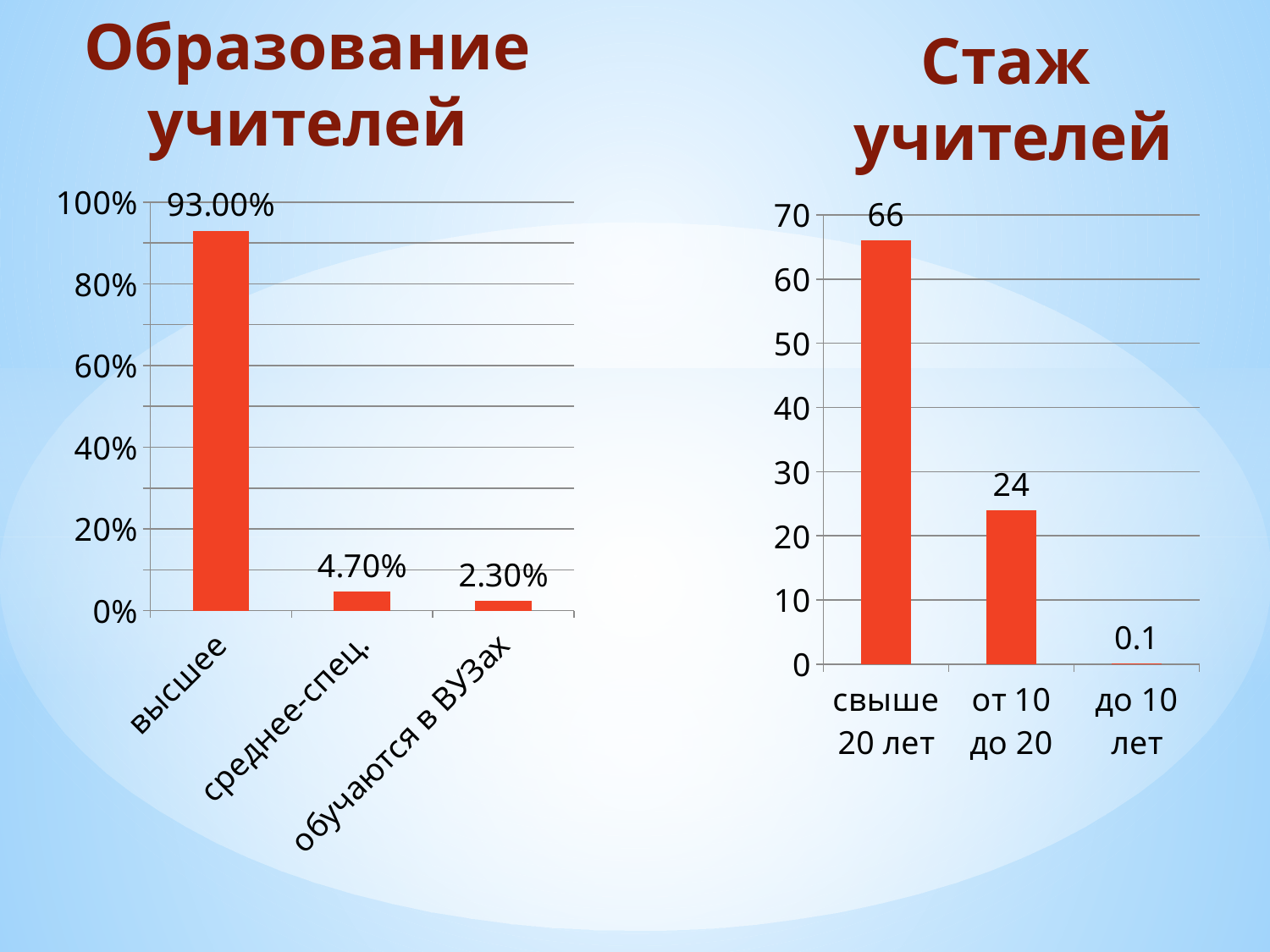
In the 'Стаж учителей' chart, what is the difference between 'свыше 20 лет' and 'от 10 до 20'? 42 In the 'Образование учителей' chart, what is the difference between 'среднее-спец.' and 'обучаются в ВУЗах'? 2.40% In the 'Стаж учителей' chart, which category has the highest value? свыше 20 лет In the 'Стаж учителей' chart, what is the value for 'свыше 20 лет'? 66 In the 'Образование учителей' chart, is the value for 'высшее' greater or less than 80%? greater In the 'Стаж учителей' chart, what is the value for 'до 10 лет'? 0.1 What type of chart is the 'Стаж учителей' chart? bar chart In the 'Образование учителей' chart, which category has the lowest value? обучаются в ВУЗах In the 'Образование учителей' chart, how many categories are shown? 3 In the 'Стаж учителей' chart, which is larger: 'от 10 до 20' or 'до 10 лет'? от 10 до 20 In the 'Образование учителей' chart, what is the value for 'высшее'? 93.00% In the 'Образование учителей' chart, what is the value for 'среднее-спец.'? 4.70%